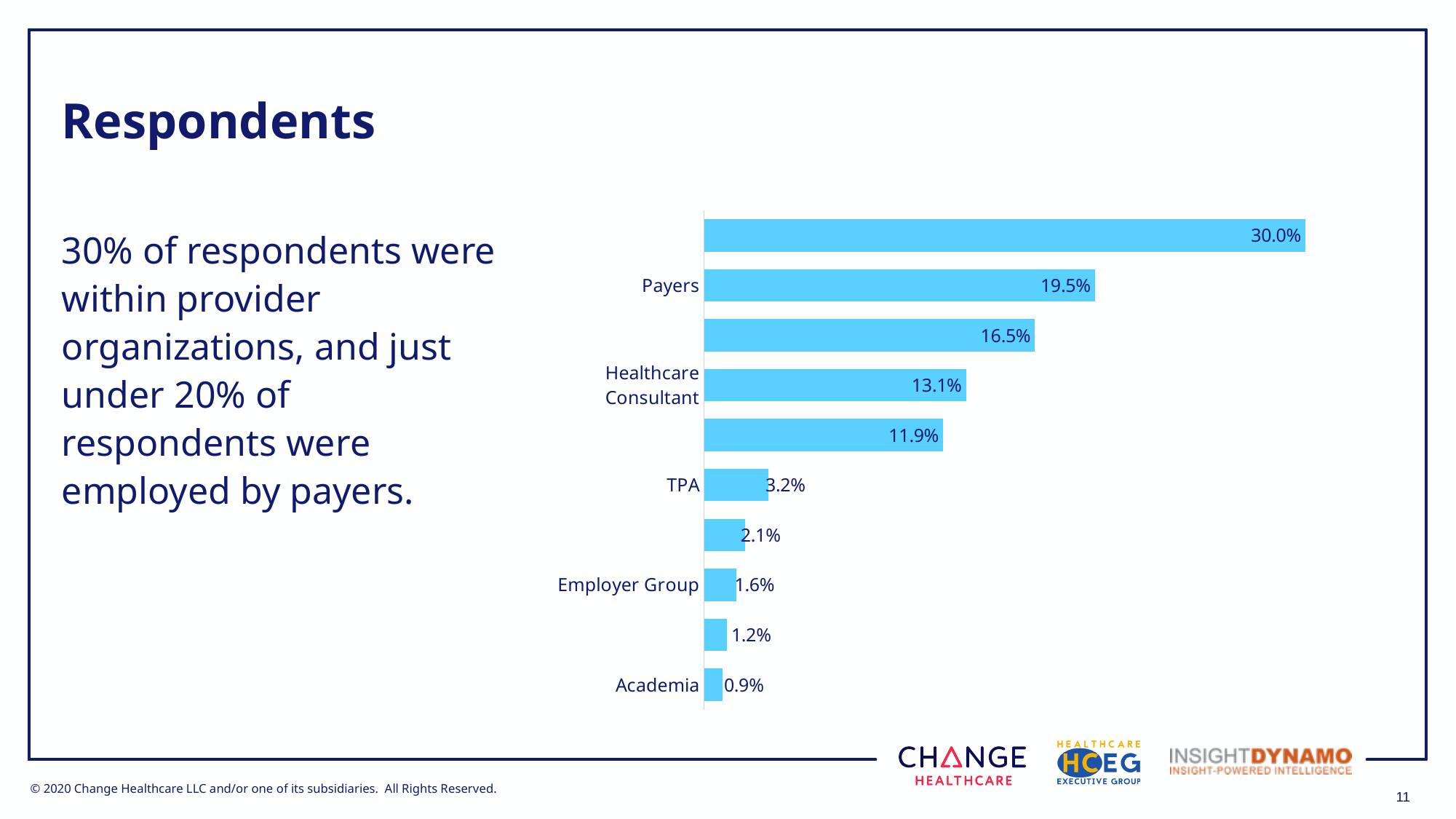
What is the value for Academia? 0.9% Which labeled category has the lowest value? Academia What is the difference between the values for Payers and Healthcare Consultant? 6.4% Which is larger, the value for TPA or the value for Employer Group? TPA How many bars are plotted on the chart? 10 Do the bar values increase or decrease from the top of the chart to the bottom? Decrease What percentage of respondents were Payers? 19.5% What is the value for Employer Group? 1.6% What is the value for TPA? 3.2% What is the largest value shown on the chart? 30.0% What is the value for Healthcare Consultant? 13.1% What kind of chart is shown on the slide? Bar chart